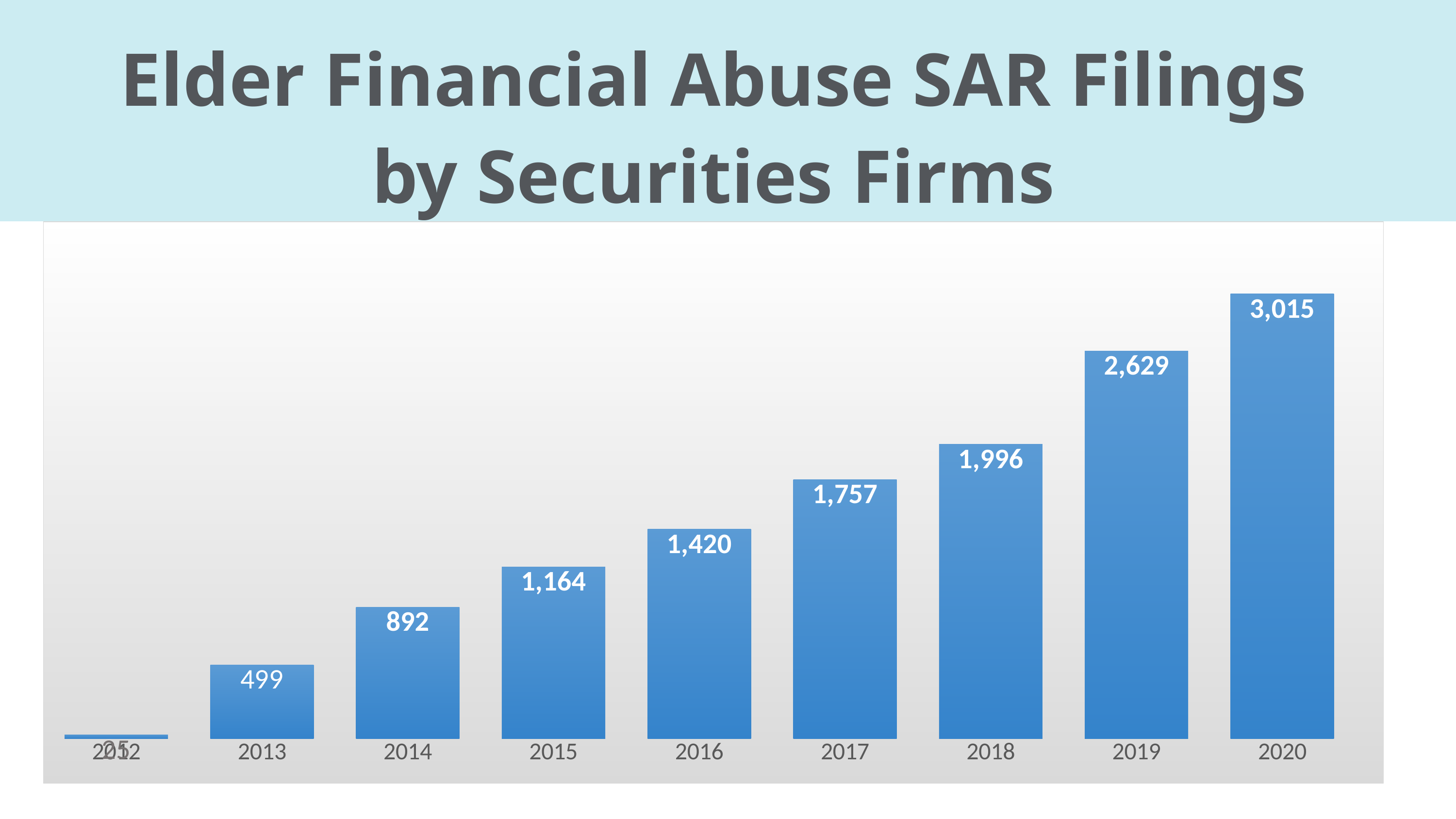
What is the value for 2020? 3,015 Which year has the lowest value? 2012 What is the value for 2018? 1,996 What is the value for 2013? 499 Which is larger, the value for 2017 or the value for 2016? 2017 Do the values rise or fall from 2012 to 2020? rise What kind of chart is this? bar chart Which year has the highest value? 2020 What is the difference between the values for 2015 and 2014? 272 What is the value for 2016? 1,420 What is the difference between the values for 2020 and 2019? 386 How many years are shown on the x axis? 9